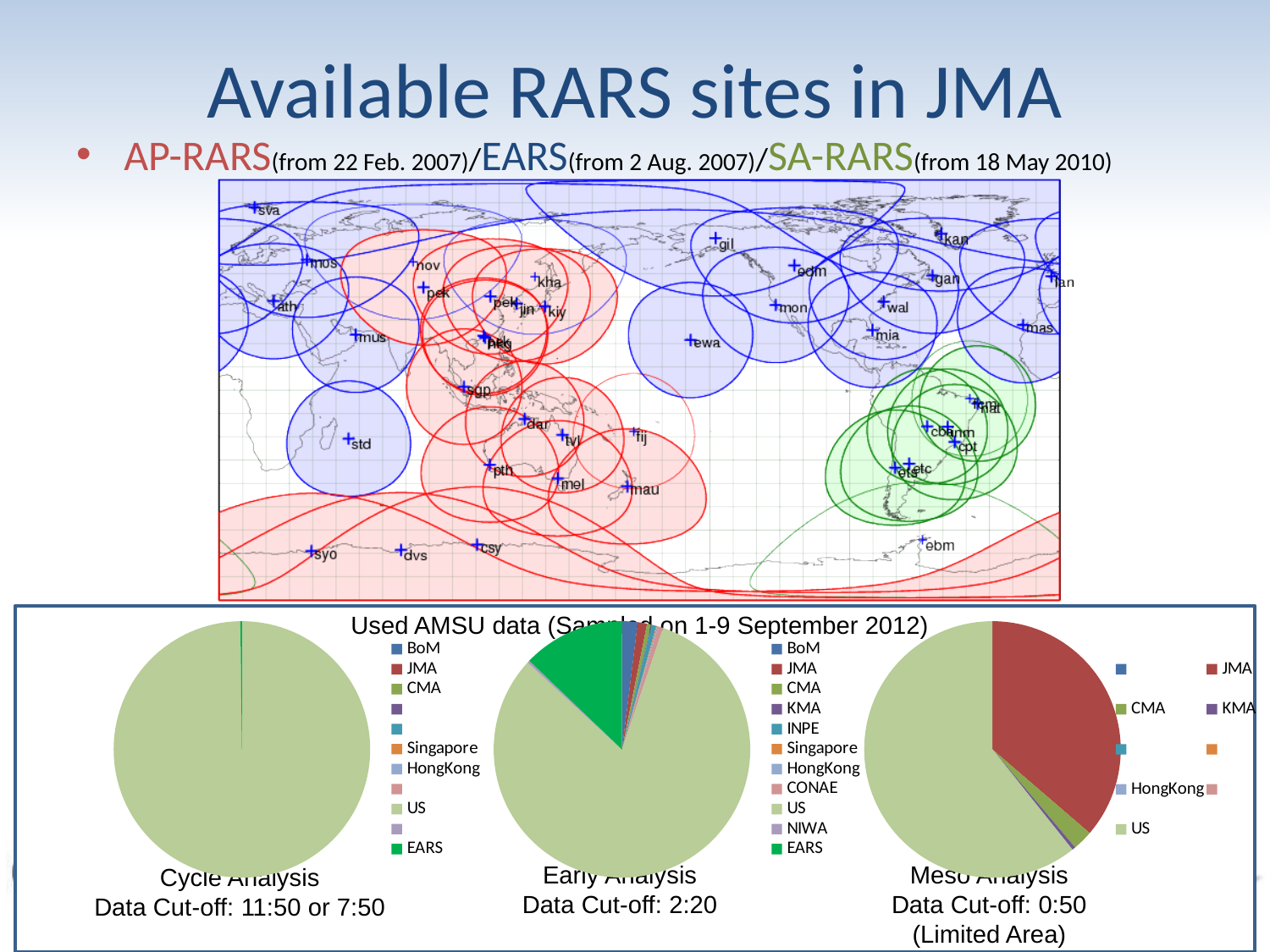
What kind of charts are shown at the bottom of the slide? Pie charts What data cut-off time is given under the Early Analysis pie chart? 2:20 How many pie charts are shown on the slide? 3 How many entries does the legend of the Early Analysis pie chart list? 11 In the Early Analysis pie chart, which is larger, the US slice or the EARS slice? US According to the title above the pie charts, on which dates was the AMSU data sampled? 1-9 September 2012 In the Meso Analysis pie chart, which category has the second largest share? JMA In the Early Analysis pie chart, which category has the largest share? US In the Meso Analysis pie chart, which is larger, the JMA slice or the CMA slice? JMA In the Cycle Analysis pie chart, which category has the largest share? US